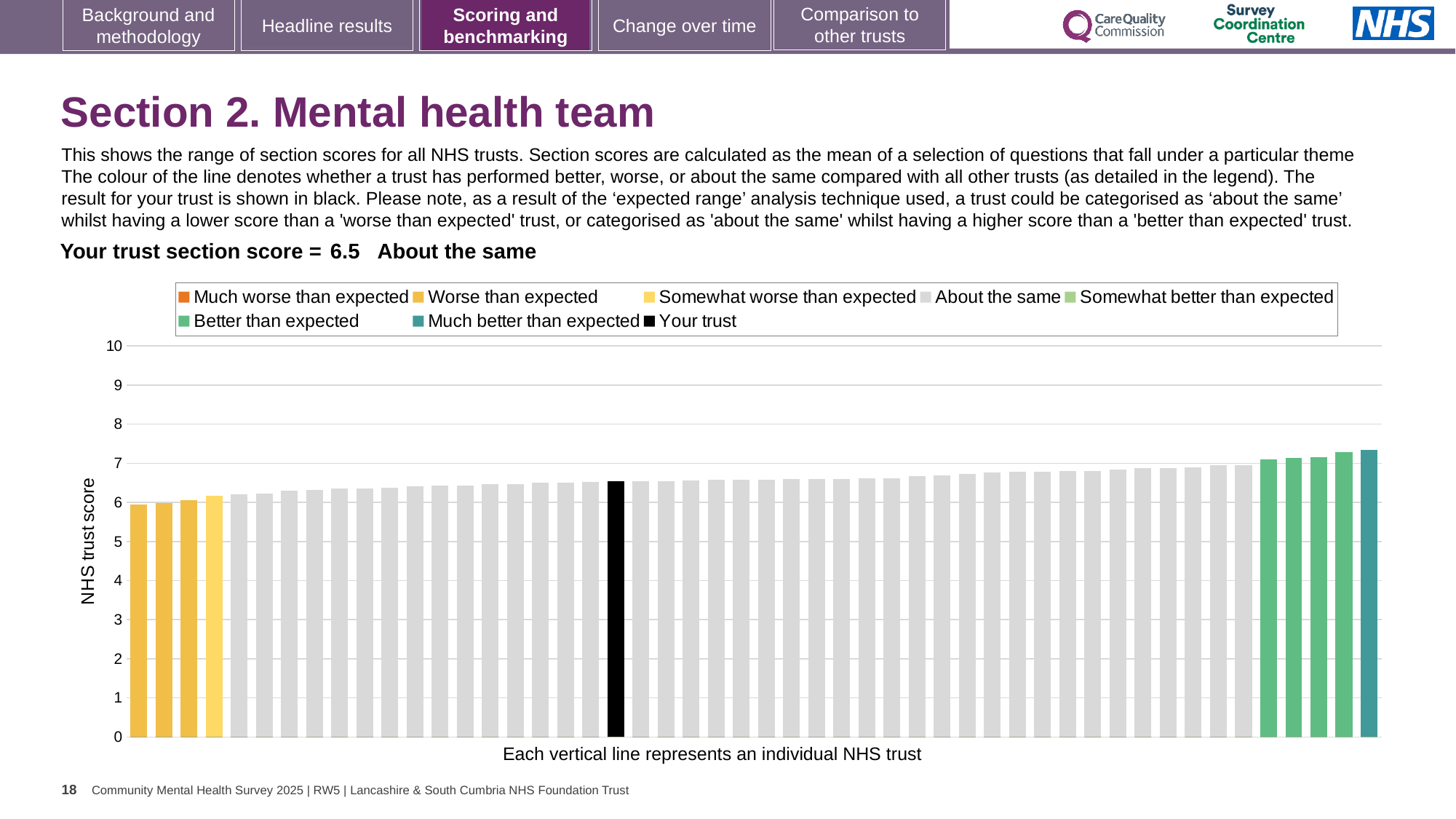
How many entries does the chart legend list? 8 Which is larger: the score for your trust or the score of the rightmost (teal) bar? The rightmost bar How many bars are coloured as 'Worse than expected'? 3 Which performance category is your trust placed in for this section? About the same Do the bar values rise or fall from left to right along the x axis? Rise What is the section score for your trust shown on the slide? 6.5 Is the value of the shortest bar (leftmost) greater or less than 7? less Is the value of the tallest bar (rightmost) greater or less than 7? greater How many bars are coloured as 'Much better than expected'? 1 Is the value for your trust (black bar) greater or less than 6? greater What is the label on the vertical axis of the chart? NHS trust score What kind of chart is shown on the slide? Bar chart